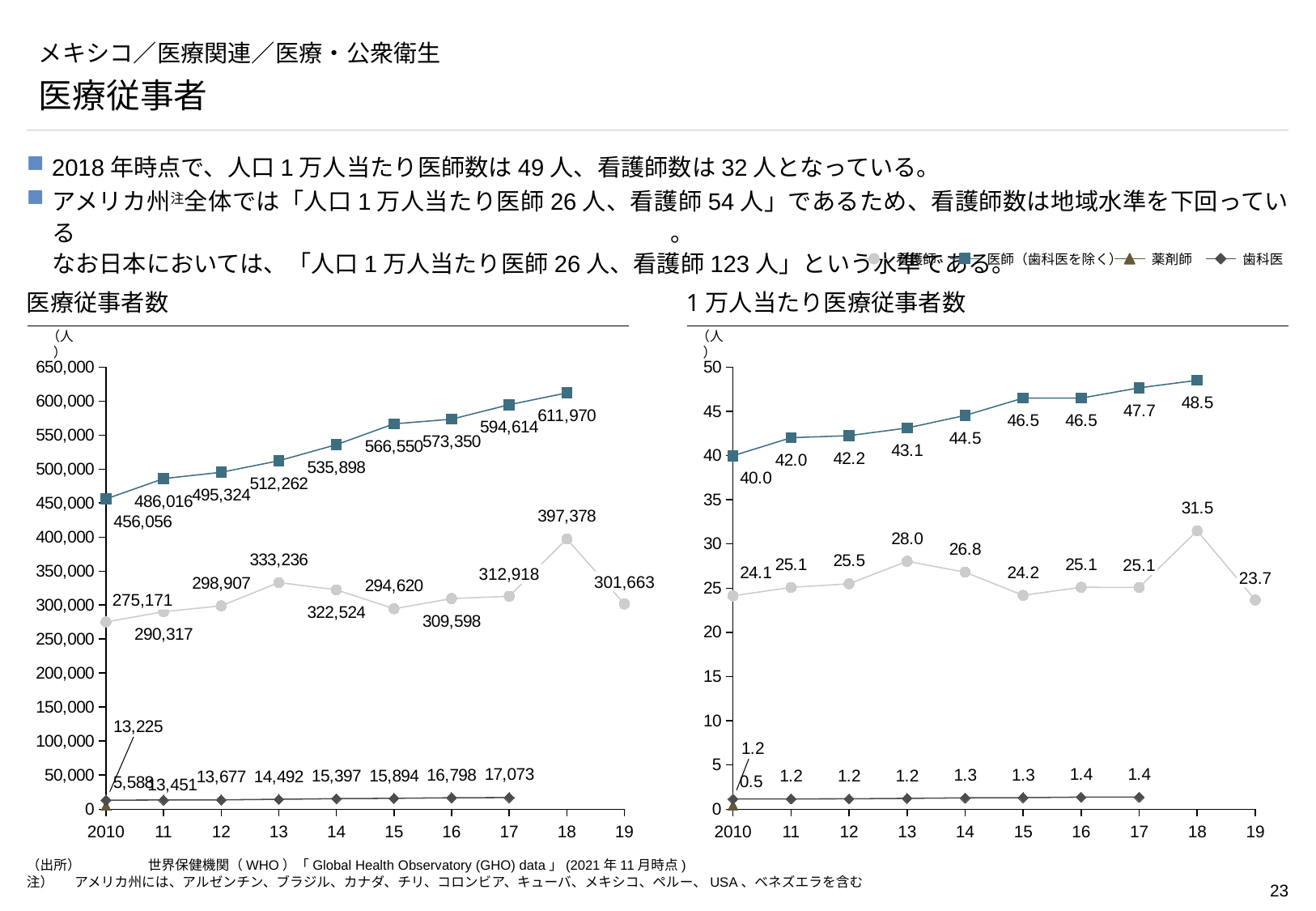
「1万人当たり医療従事者数」のグラフで、2018年の看護師の値はいくつですか？ 31.5 「医療従事者数」のグラフで、2018年の医師（歯科医を除く）の値はいくつですか？ 611,970 「1万人当たり医療従事者数」のグラフで、2013年の看護師と2015年の看護師ではどちらが大きいですか？ 2013年 「医療従事者数」のグラフで、2013年の看護師の値はいくつですか？ 333,236 「1万人当たり医療従事者数」のグラフで、2018年の医師（歯科医を除く）と看護師の差はいくつですか？ 17.0 「医療従事者数」のグラフで、看護師の値が最も高いのは何年ですか？ 2018年 「医療従事者数」のグラフで、2017年の歯科医の値はいくつですか？ 17,073 凡例にはいくつの系列が示されていますか？ 4 「医療従事者数」のグラフで、医師（歯科医を除く）の値は2010年から2018年にかけて増加していますか、減少していますか？ 増加 「医療従事者数」のグラフで、2018年の医師（歯科医を除く）と2010年の医師（歯科医を除く）の差はいくつですか？ 155,914 「1万人当たり医療従事者数」のグラフで、看護師の値が最も低いのは何年ですか？ 2019年 「1万人当たり医療従事者数」のグラフで、2010年の薬剤師の値はいくつですか？ 0.5